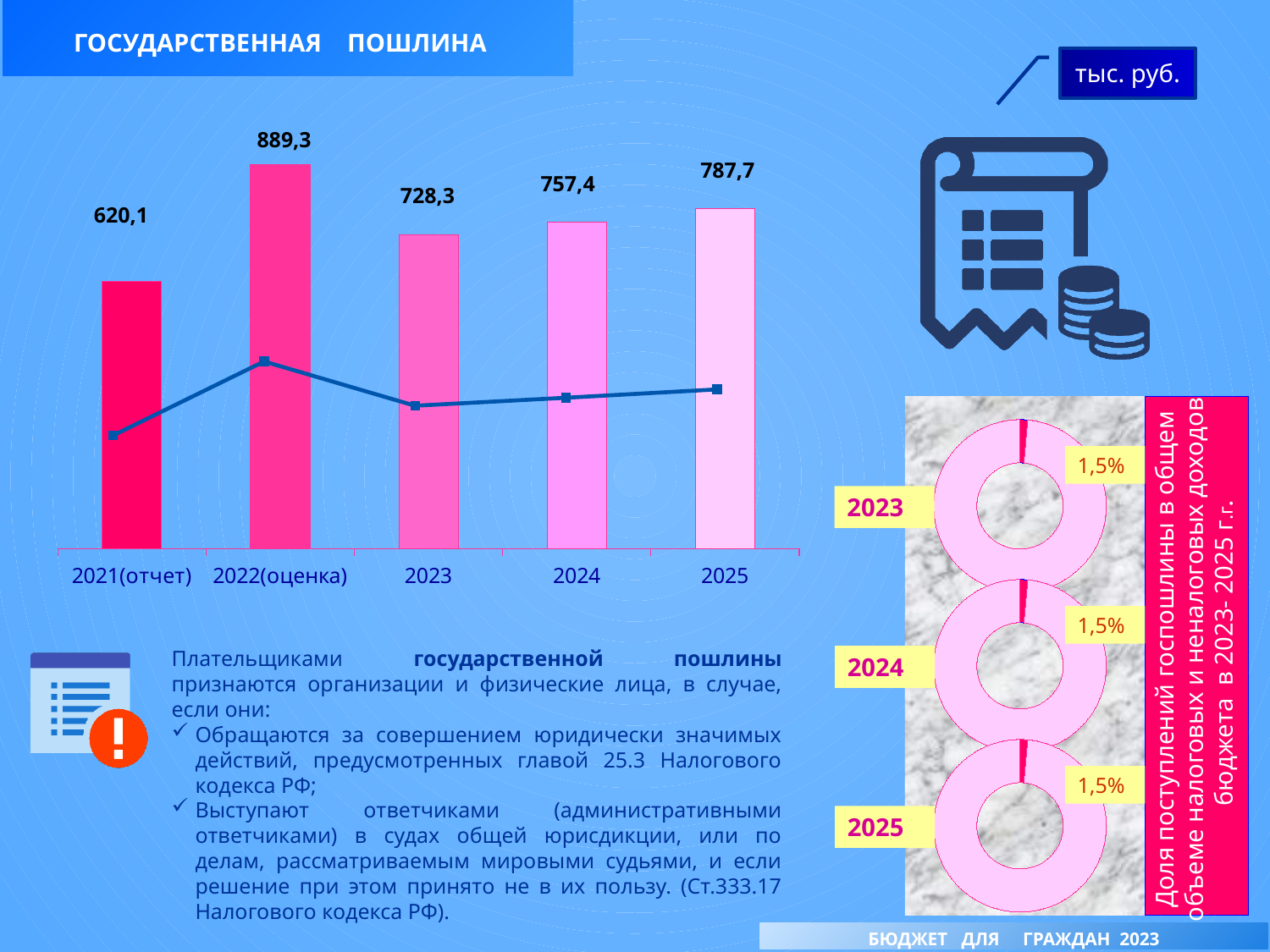
In the bar chart on the left, which is larger: the value for 2023 or the value for 2025? 2025 How many bars are shown in the bar chart on the left? 5 What unit is indicated for the values in the bar chart on the left? тыс. руб. In the bar chart on the left, do the values rise or fall from 2023 to 2025? rise In the donut charts on the right, what share is shown for 2024? 1,5% In the bar chart on the left, what is the value for 2024? 757,4 In the bar chart on the left, what is the difference between the values for 2022(оценка) and 2021(отчет)? 269,2 In the bar chart on the left, what is the value for 2021(отчет)? 620,1 In the bar chart on the left, what is the difference between the values for 2025 and 2023? 59,4 In the bar chart on the left, which year has the highest value? 2022(оценка) In the bar chart on the left, which year has the lowest value? 2021(отчет) In the bar chart on the left, what is the value for 2022(оценка)? 889,3